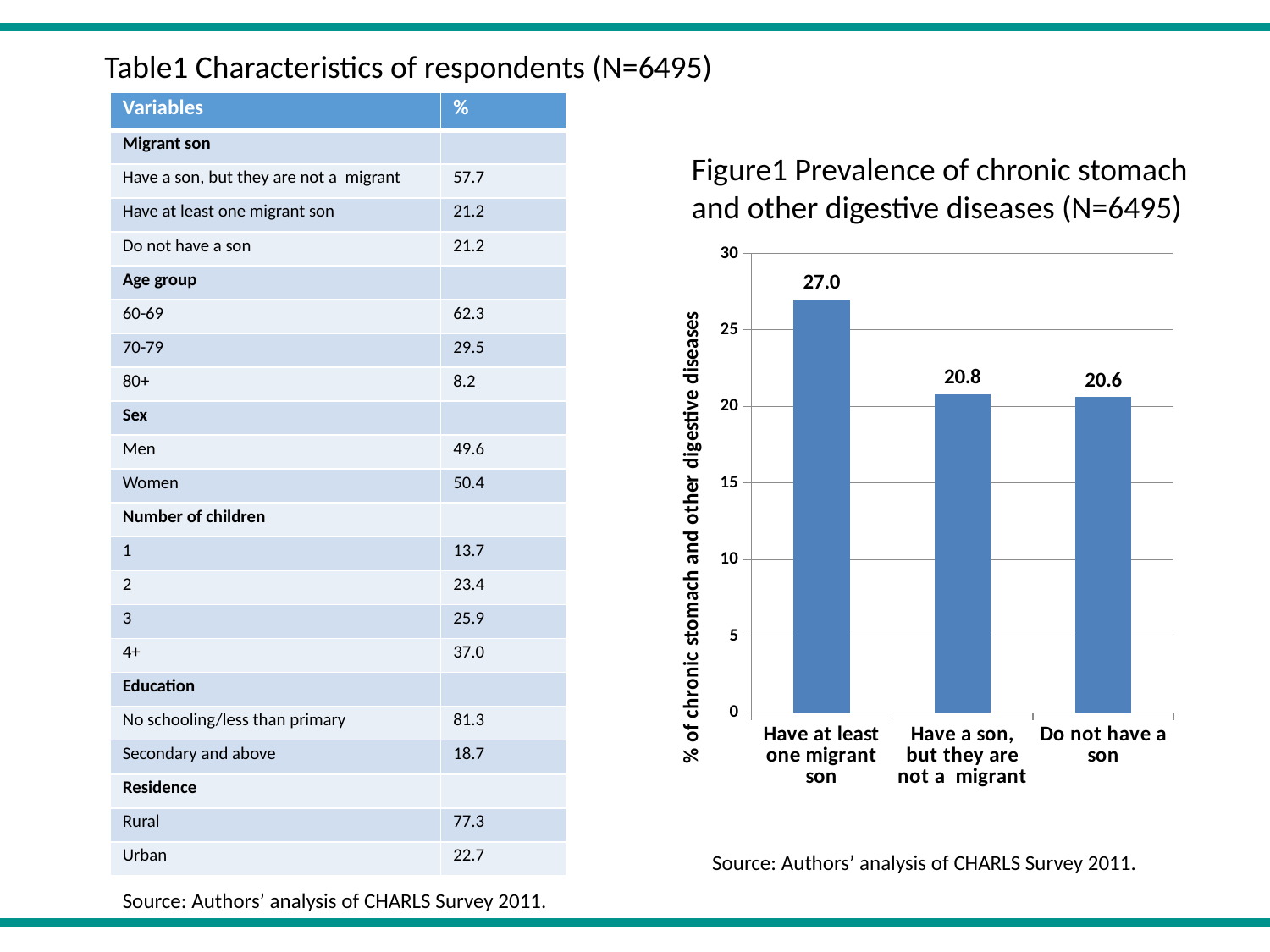
What is the value for 'Do not have a son' in Figure 1? 20.6 What is the difference between the values for 'Have at least one migrant son' and 'Have a son, but they are not a migrant' in Figure 1? 6.2 What is the difference between the values for 'Have at least one migrant son' and 'Do not have a son' in Figure 1? 6.4 What kind of chart is Figure 1? Bar chart What is the value for 'Have a son, but they are not a migrant' in Figure 1? 20.8 Which category has the highest value in Figure 1? Have at least one migrant son How many categories are shown in Figure 1? 3 Is the value for 'Do not have a son' in Figure 1 greater or less than 25? less What is the y-axis label of Figure 1? % of chronic stomach and other digestive diseases What is the value for 'Have at least one migrant son' in Figure 1? 27.0 In Figure 1, is the value for 'Have at least one migrant son' larger than the value for 'Have a son, but they are not a migrant'? Yes Is the value for 'Have at least one migrant son' in Figure 1 greater or less than 25? greater